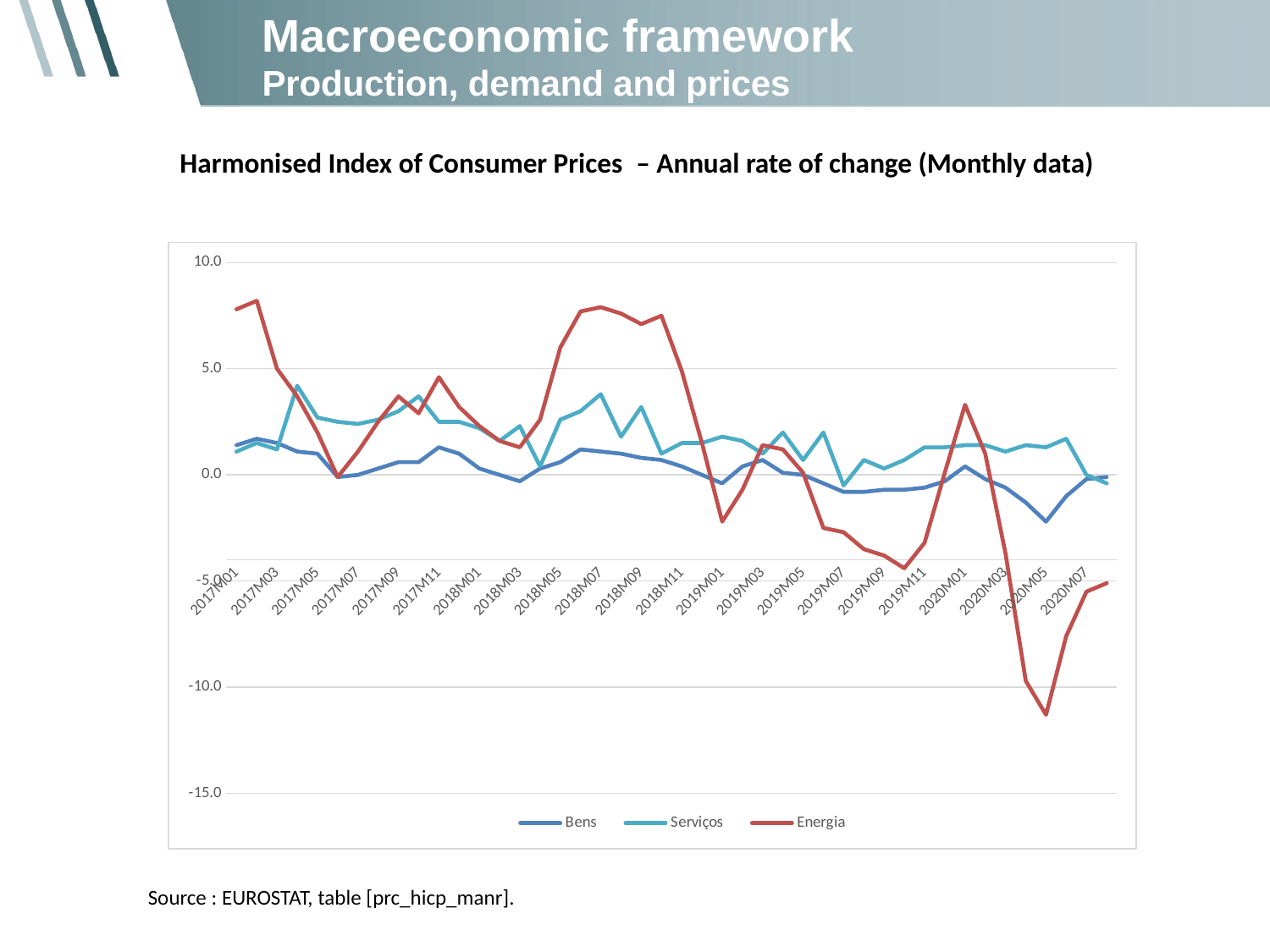
Does the Energia line rise or fall between 2020M01 and 2020M05? Fall How many month labels are printed along the x axis? 22 Is the value for Energia at 2017M01 greater or less than 5.0? greater How many series does the legend list? 3 At 2017M01, which is larger, the value for Energia or the value for Bens? Energia Which series reaches the lowest value on the chart? Energia What kind of chart is shown on the slide? Line chart What colour is the Energia line? Red Which series reaches the highest value on the chart? Energia What are the three series named in the legend? Bens, Serviços, Energia Is the value for Energia at 2020M05 greater or less than -10.0? less Is the value for Energia at 2018M07 greater or less than 5.0? greater